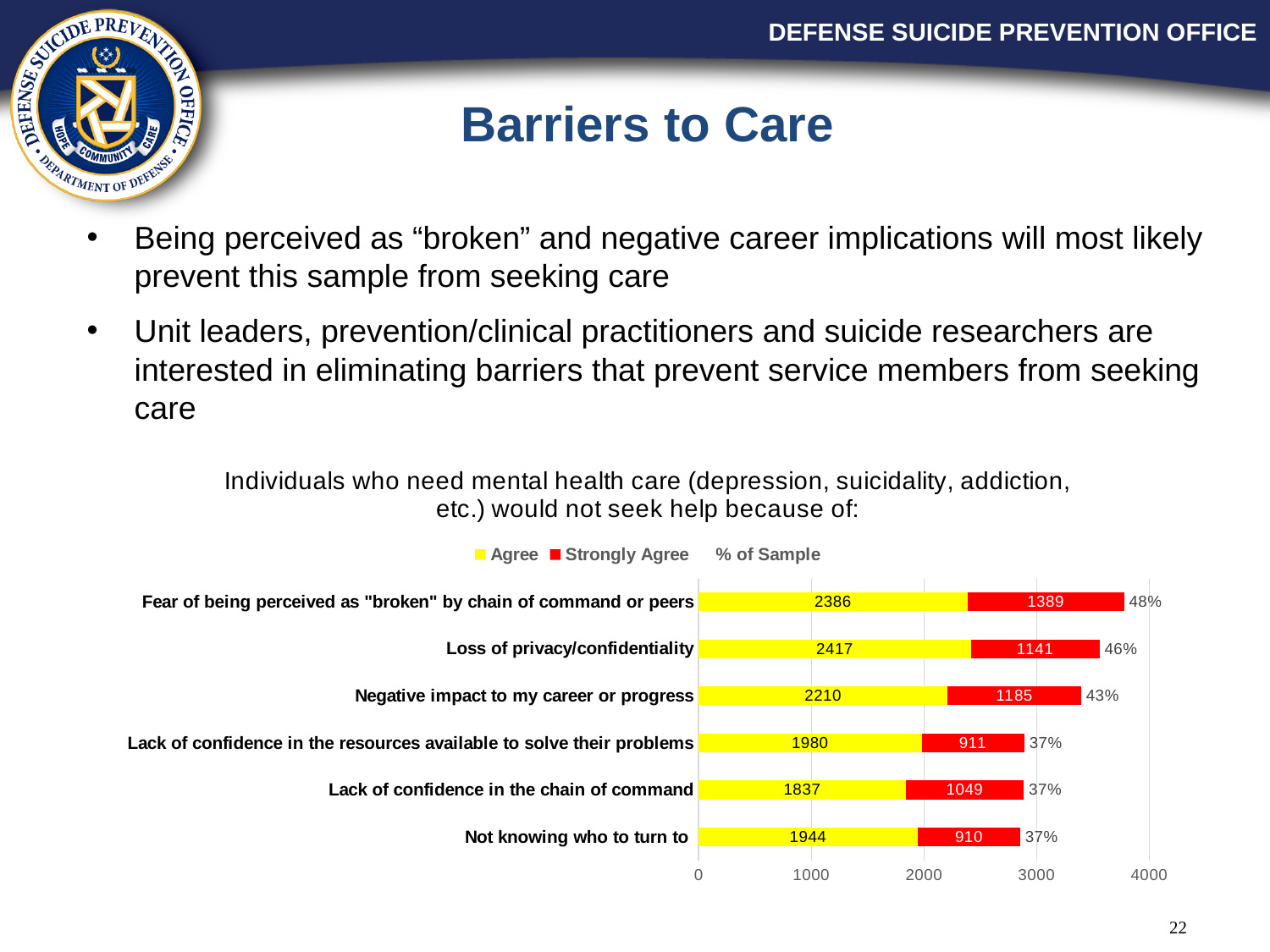
What is the difference between the Agree and Strongly Agree values for "Fear of being perceived as "broken" by chain of command or peers"? 997 What is the Strongly Agree value for "Negative impact to my career or progress"? 1185 What is the total of the Agree and Strongly Agree values for "Fear of being perceived as "broken" by chain of command or peers"? 3775 How many barrier categories are shown in the chart? 6 Which category has the lowest Agree value? Lack of confidence in the chain of command Which category has the highest Agree value? Loss of privacy/confidentiality What is the Agree value for "Loss of privacy/confidentiality"? 2417 What percentage of the sample is shown for "Lack of confidence in the chain of command"? 37% What kind of chart is shown on the slide? Stacked bar chart What percentage of the sample is shown for "Fear of being perceived as "broken" by chain of command or peers"? 48% Which has the larger Strongly Agree value: "Lack of confidence in the chain of command" or "Lack of confidence in the resources available to solve their problems"? Lack of confidence in the chain of command Is the Agree value for "Not knowing who to turn to" greater or less than 2000? less